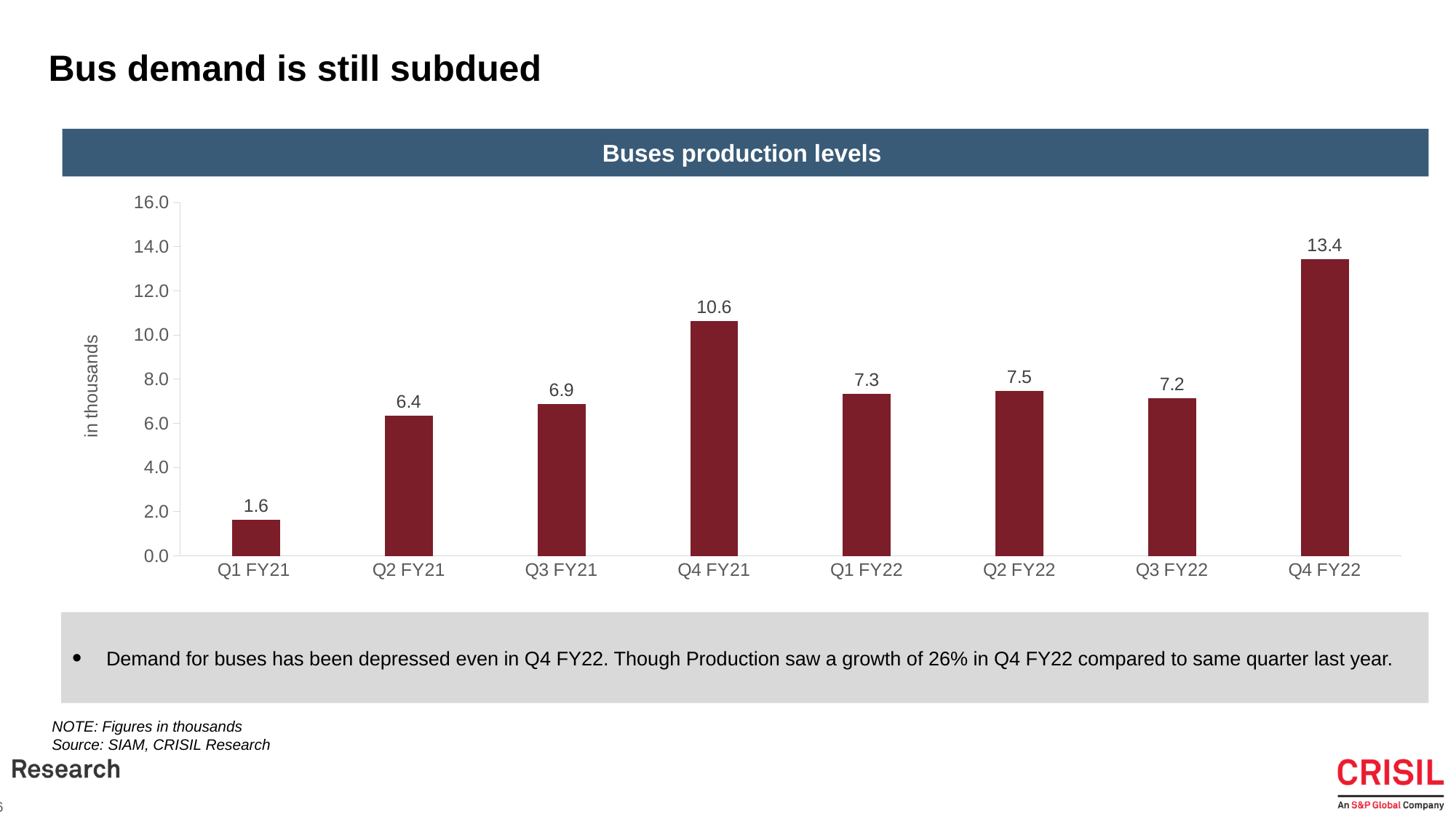
How many quarters are shown on the x axis? 8 What is the title of the chart? Buses production levels What kind of chart is shown on the slide? bar chart Which is larger, the value for Q3 FY21 or the value for Q2 FY21? Q3 FY21 What is the value for Q1 FY21? 1.6 Which quarter has the highest buses production level? Q4 FY22 Do the values rise or fall from Q1 FY21 to Q4 FY21? rise Which quarter has the lowest buses production level? Q1 FY21 What is the difference between the values for Q4 FY22 and Q4 FY21? 2.8 Is the value for Q1 FY22 greater or less than 8.0? less What is the value for Q4 FY21? 10.6 What is the value for Q2 FY22? 7.5